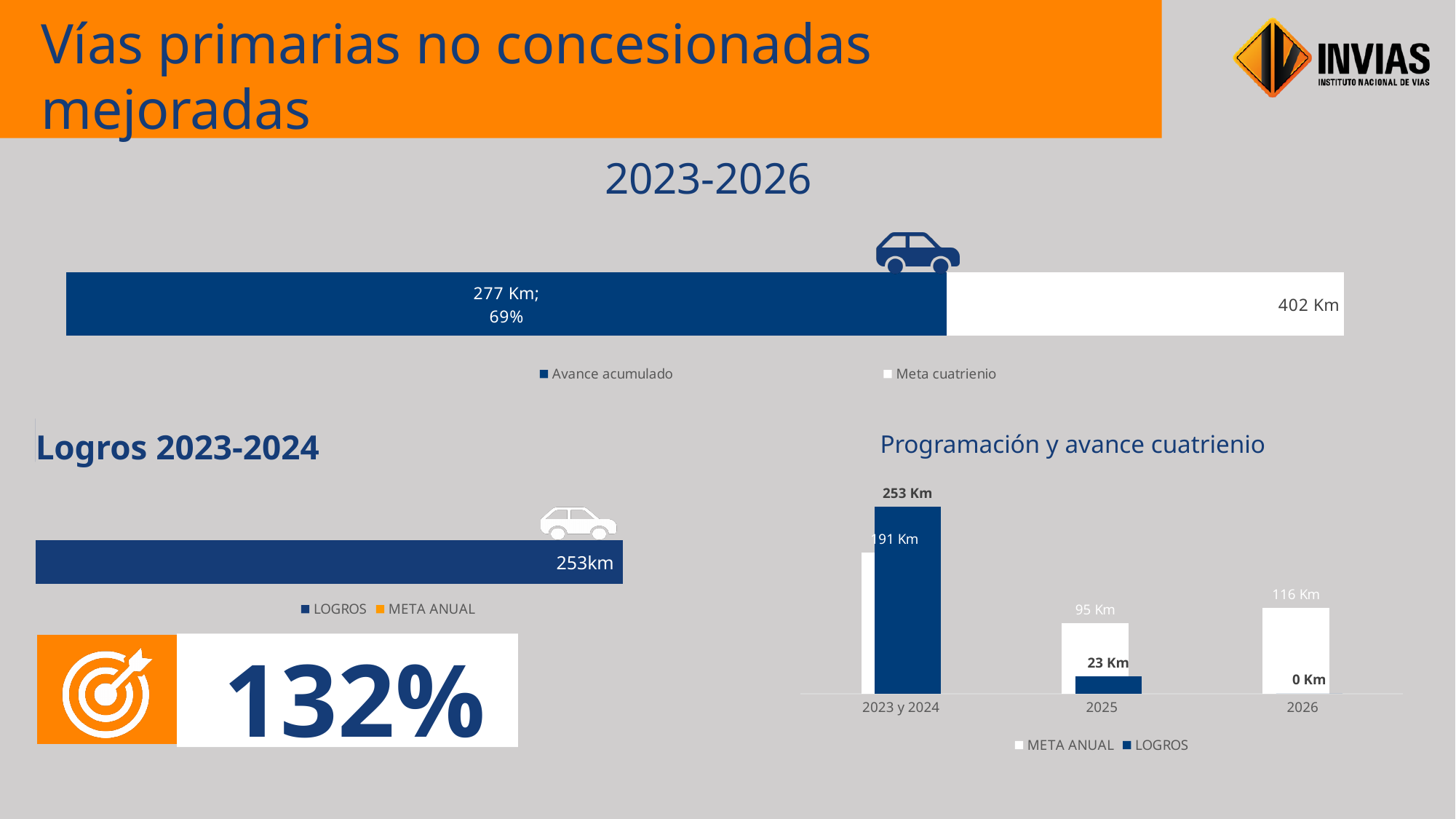
In the 'Programación y avance cuatrienio' chart, how many categories are shown on the x axis? 3 In the 'Programación y avance cuatrienio' chart, what is the LOGROS value for 2025? 23 Km In the 'Programación y avance cuatrienio' chart, what is the LOGROS value for 2023 y 2024? 253 Km In the '2023-2026' chart at the top, how many series does the legend list? 2 In the '2023-2026' chart at the top, what is the value for Meta cuatrienio? 402 Km In the '2023-2026' chart at the top, what percentage is shown on the Avance acumulado bar? 69% In the 'Logros 2023-2024' chart, what is the value for LOGROS? 253km What kind of chart is 'Programación y avance cuatrienio'? Bar chart In the 'Programación y avance cuatrienio' chart, which category has the highest META ANUAL value? 2023 y 2024 In the '2023-2026' chart at the top, what is the value for Avance acumulado? 277 Km In the 'Programación y avance cuatrienio' chart, what is the difference between META ANUAL and LOGROS for 2025? 72 Km In the 'Programación y avance cuatrienio' chart, what is the META ANUAL value for 2026? 116 Km